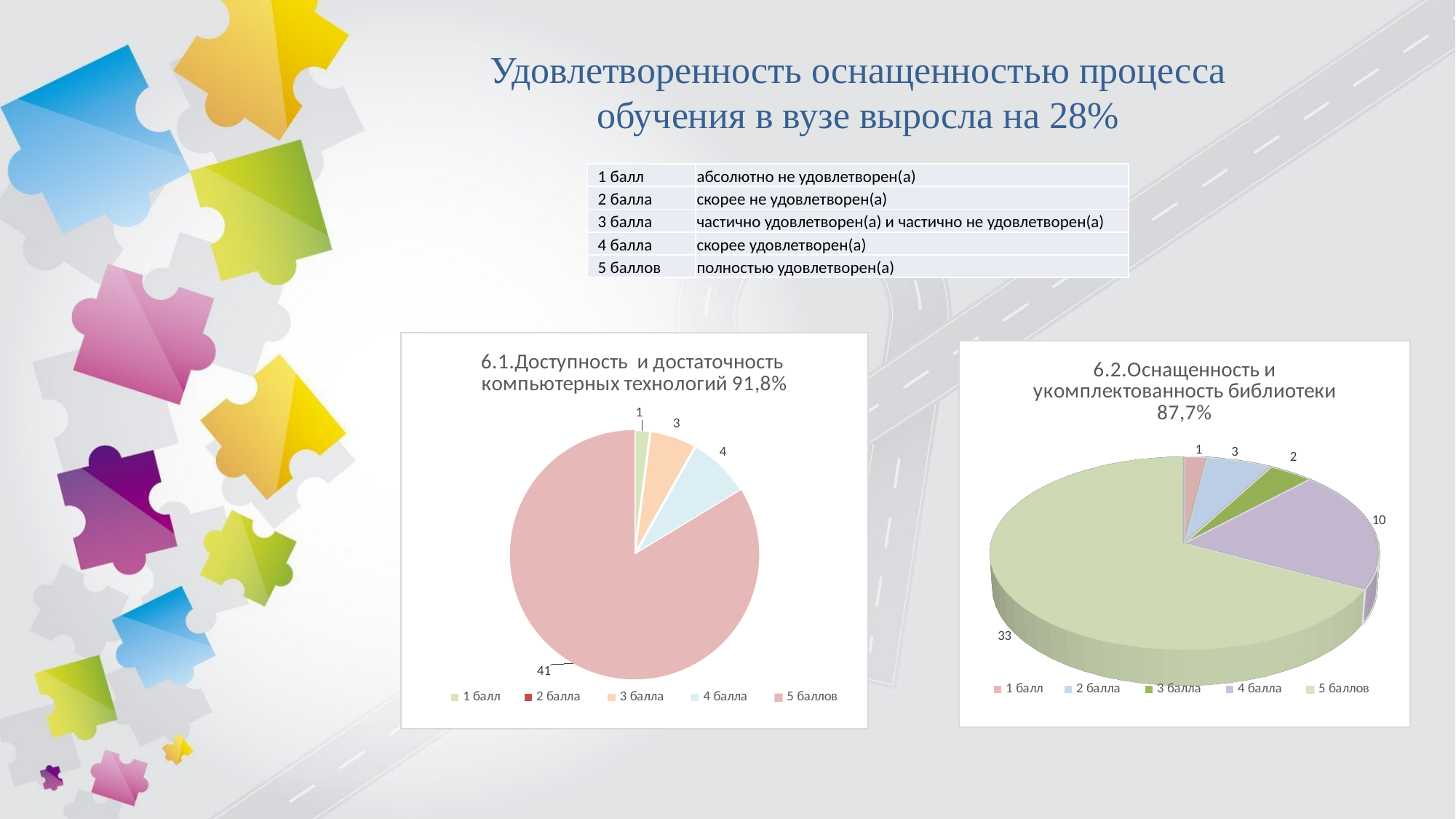
In the right chart (6.2), what value is shown for the 4 балла slice? 10 In the right chart (6.2), which category has the largest slice? 5 баллов In the right chart (6.2), what value is shown for the 5 баллов slice? 33 In the left chart (6.1), what value is shown for the 4 балла slice? 4 In the right chart (6.2), what is the difference between the 5 баллов value and the 4 балла value? 23 In the right chart (6.2), which is larger: the value for 2 балла or the value for 3 балла? 2 балла In the left chart (6.1), what is the difference between the 5 баллов value and the 4 балла value? 37 In the left chart (6.1), what value is shown for the 5 баллов slice? 41 In the left chart (6.1), which category has the largest slice? 5 баллов In the right chart (6.2), what value is shown for the 2 балла slice? 3 In the right chart (6.2), which category has the smallest slice? 1 балл What type of chart is the left chart (6.1)? Pie chart